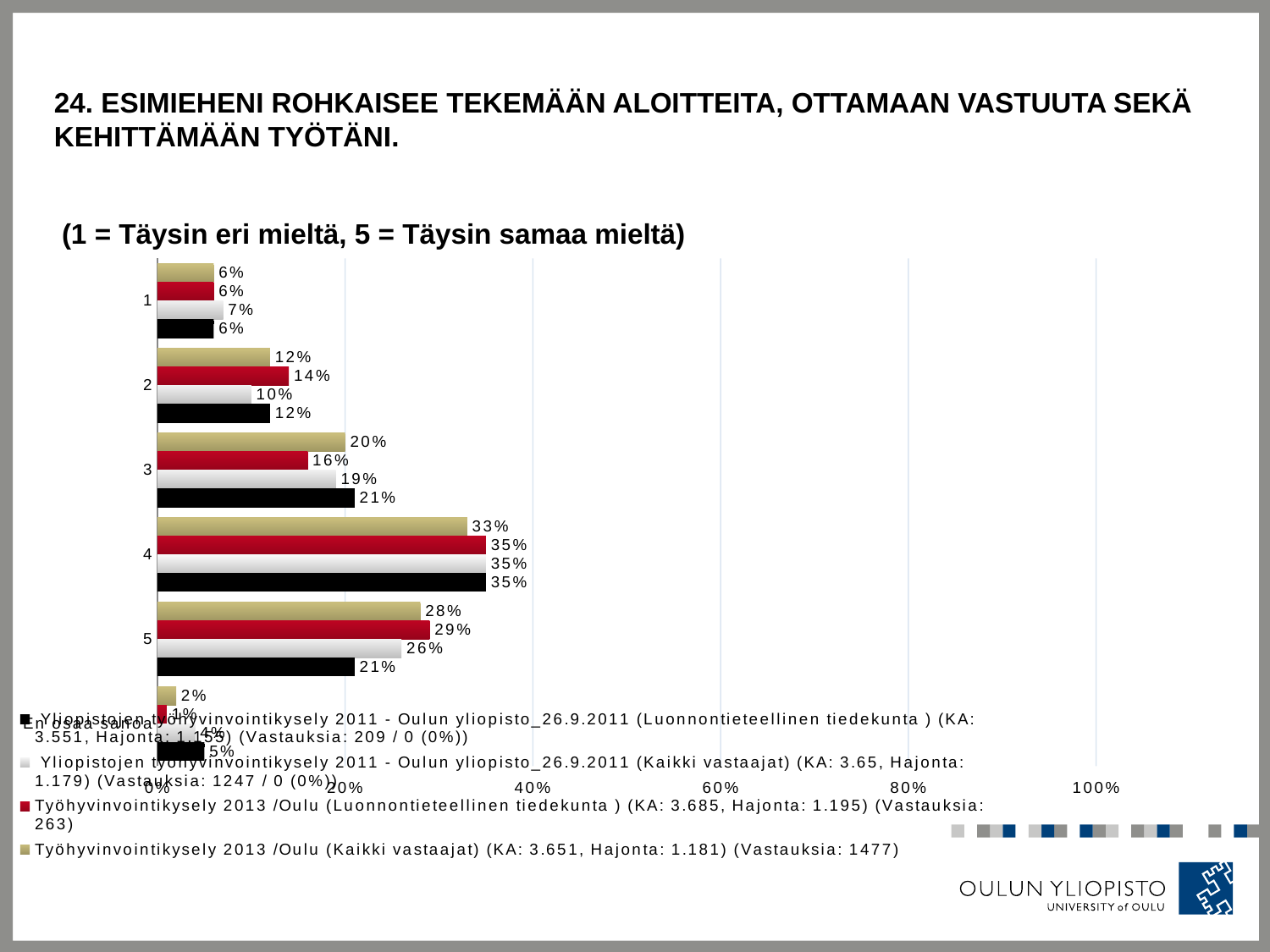
What is the value for category 4 in the 'Työhyvinvointikysely 2013 /Oulu (Kaikki vastaajat)' series? 33% What is the highest tick value shown on the horizontal axis? 100% In the 'Työhyvinvointikysely 2013 /Oulu (Kaikki vastaajat)' series, which category has the highest value? 4 What kind of chart is shown on the slide? bar chart For category 5, what is the difference between the 'Työhyvinvointikysely 2013 /Oulu (Luonnontieteellinen tiedekunta)' value and the 'Yliopistojen työhyvinvointikysely 2011 (Luonnontieteellinen tiedekunta)' value? 8 percentage points How many series does the legend list? 4 What is the value for category 3 in the 'Yliopistojen työhyvinvointikysely 2011 - Oulun yliopisto_26.9.2011 (Luonnontieteellinen tiedekunta)' series? 21% Is the value for category 4 in the 'Yliopistojen työhyvinvointikysely 2011 (Luonnontieteellinen tiedekunta)' series greater or less than 20%? greater For category 3, which is larger: the 'Työhyvinvointikysely 2013 /Oulu (Kaikki vastaajat)' value or the 'Työhyvinvointikysely 2013 /Oulu (Luonnontieteellinen tiedekunta)' value? Työhyvinvointikysely 2013 /Oulu (Kaikki vastaajat) What is the value for category 5 in the 'Työhyvinvointikysely 2013 /Oulu (Luonnontieteellinen tiedekunta)' series? 29% What is the value for category 2 in the 'Yliopistojen työhyvinvointikysely 2011 - Oulun yliopisto_26.9.2011 (Kaikki vastaajat)' series? 10% Among categories 1 to 5, which has the lowest value in the 'Työhyvinvointikysely 2013 /Oulu (Luonnontieteellinen tiedekunta)' series? 1